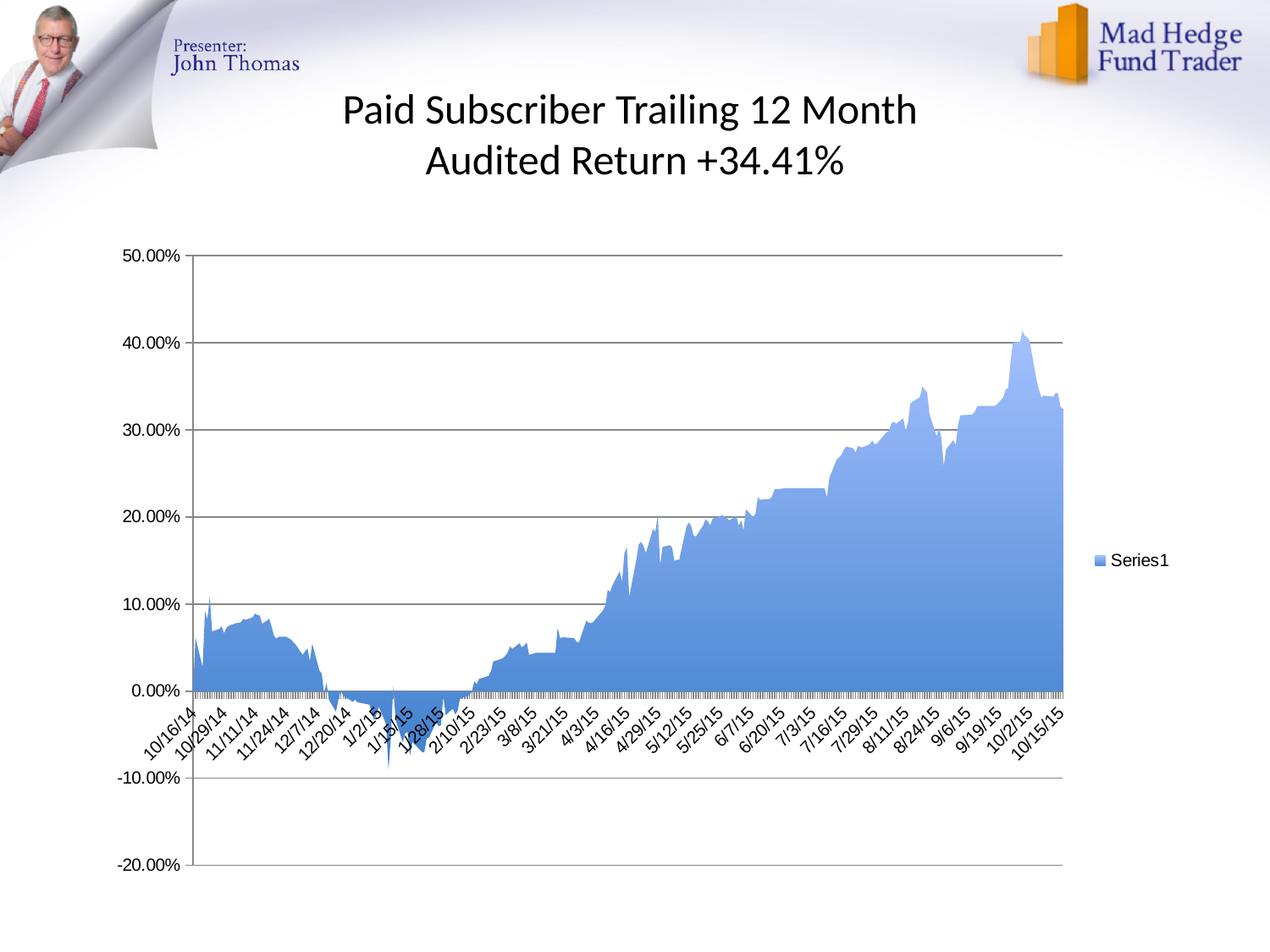
Is the value for 10/2/15 greater or less than 30.00%? greater Around which x-axis date does the chart reach its highest value? 10/2/15 Which has the larger value, 1/15/15 or 6/7/15? 6/7/15 What kind of chart is shown on the slide? Area chart Is the value for 11/11/14 greater or less than 10.00%? less What is the title of the slide above the chart? Paid Subscriber Trailing 12 Month Audited Return +34.41% Overall, do the values rise or fall from 10/16/14 to 10/15/15? Rise What is the name of the series shown in the legend? Series1 Is the value for 1/15/15 greater or less than 0.00%? less Which has the larger value, 10/2/15 or 10/16/14? 10/2/15 How many series does the legend list? 1